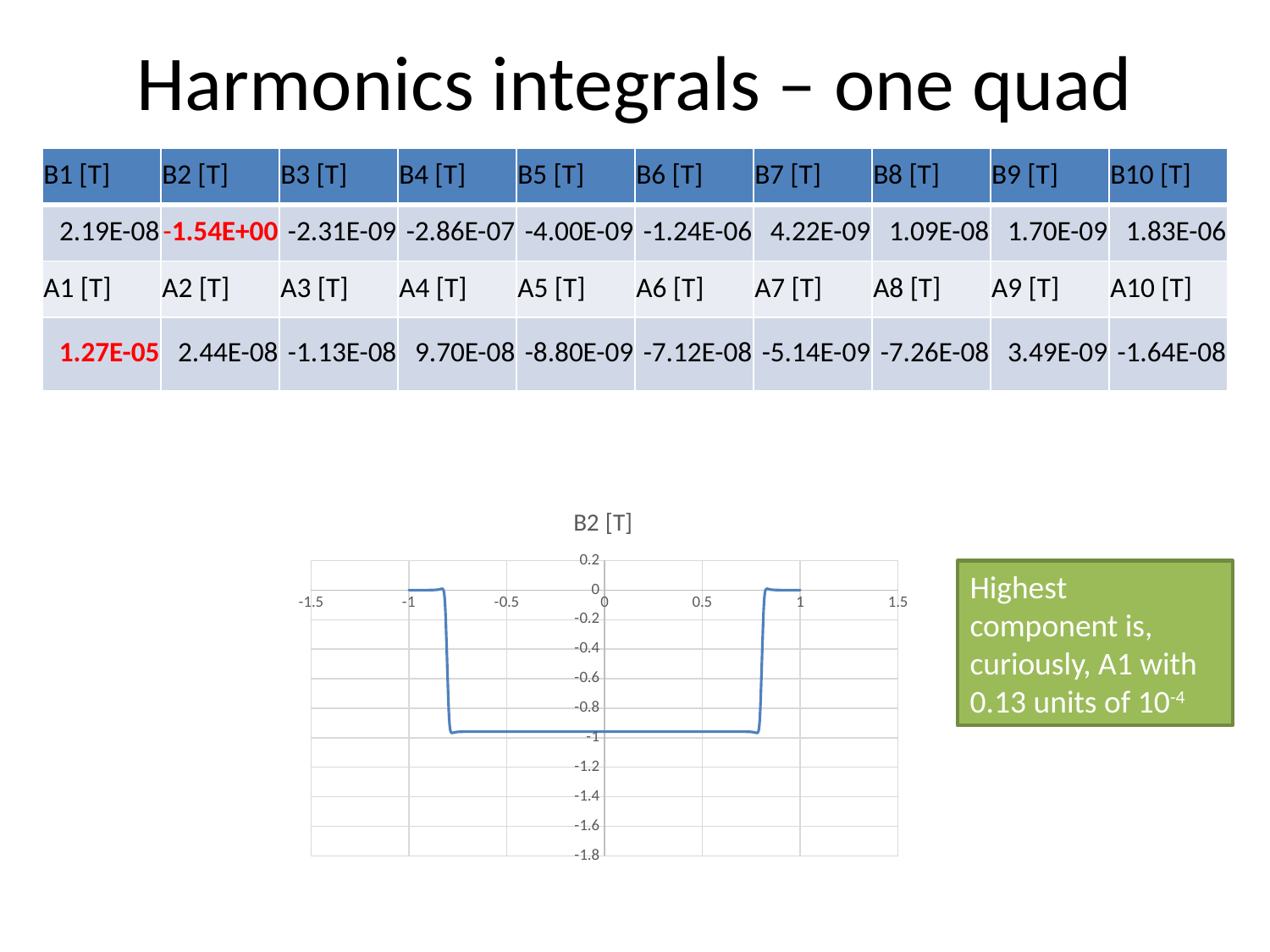
In the B2 [T] chart, is the value at x = 0 greater or less than -1.2? greater In the B2 [T] chart, is the value at x = 0.5 greater or less than -0.8? less In the B2 [T] chart, is the value at x = 0 greater or less than -0.5? less In the B2 [T] chart, which is larger: the value at x = -1 or the value at x = 0? the value at x = -1 What is the lowest value shown on the y axis of the B2 [T] chart? -1.8 What kind of chart is shown on the slide? line chart What is the title of the chart on the slide? B2 [T] In the B2 [T] chart, do the values rise or fall as x goes from 0.5 to 1? rise In the B2 [T] chart, do the values rise or fall as x goes from -1 to -0.5? fall In the B2 [T] chart, which is larger: the value at x = 0.5 or the value at x = 1? the value at x = 1